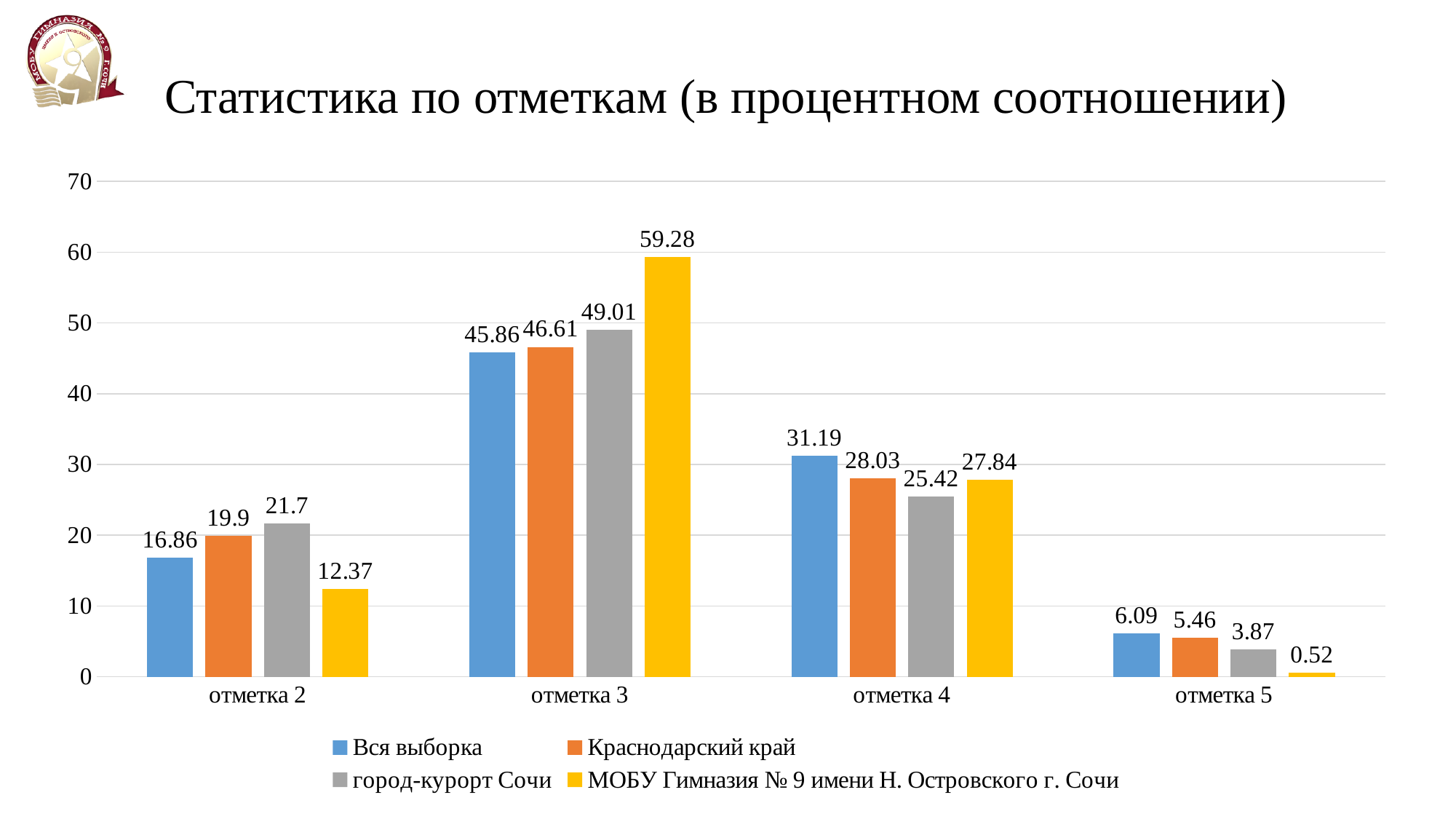
What kind of chart is shown on the slide? bar chart What is the value for город-курорт Сочи at отметка 5? 3.87 Which is larger at отметка 4: Краснодарский край or город-курорт Сочи? Краснодарский край What is the value for Вся выборка at отметка 3? 45.86 What is the value for МОБУ Гимназия № 9 имени Н. Островского г. Сочи at отметка 2? 12.37 How many categories are shown on the x axis? 4 Is the value for Вся выборка at отметка 4 greater or less than 30? greater What is the difference between the МОБУ Гимназия № 9 value and the Вся выборка value at отметка 3? 13.42 Which series has the lowest value at отметка 5? МОБУ Гимназия № 9 имени Н. Островского г. Сочи Which series has the highest value at отметка 3? МОБУ Гимназия № 9 имени Н. Островского г. Сочи How many series does the legend list? 4 What is the title of the chart? Статистика по отметкам (в процентном соотношении)